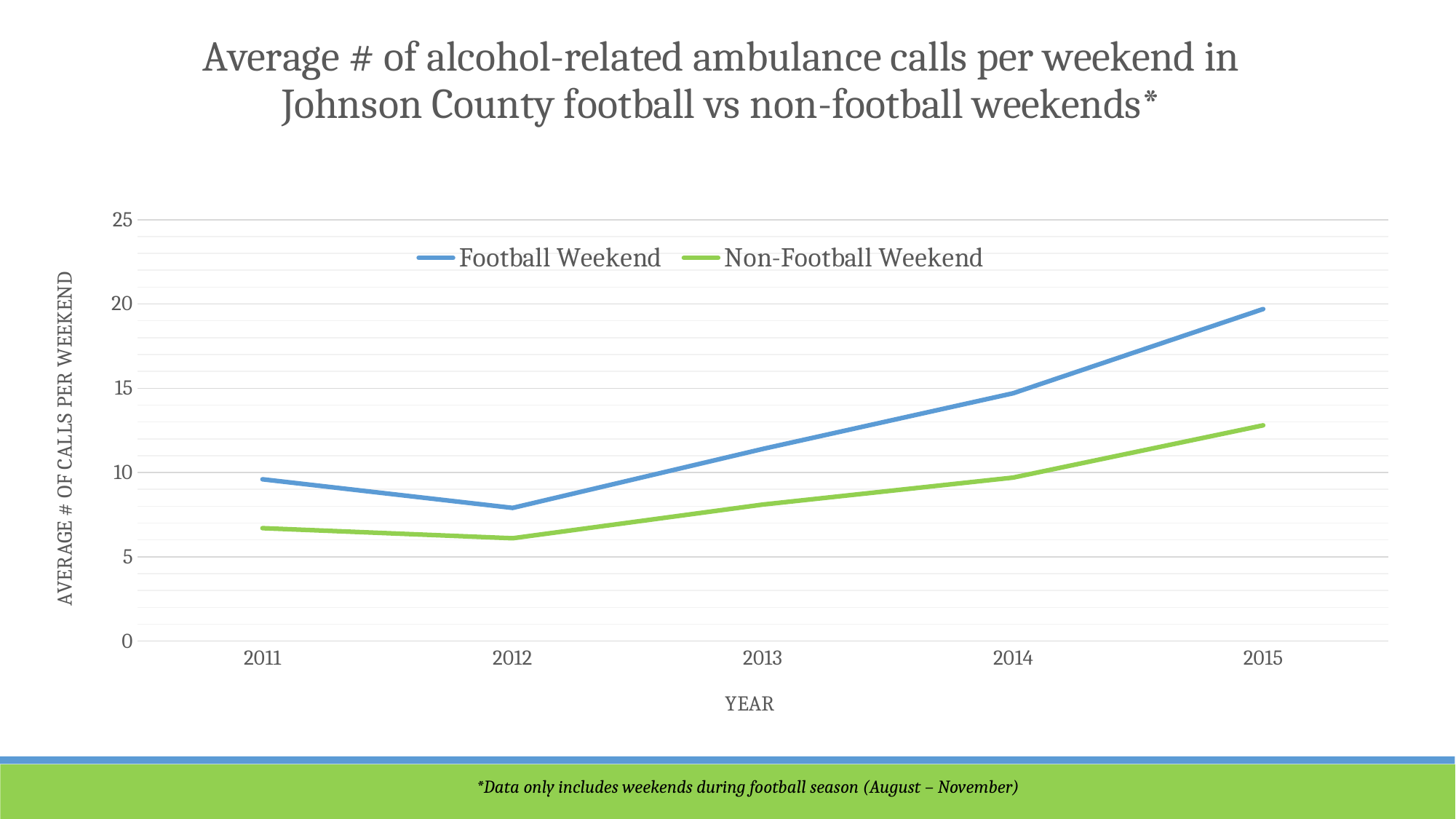
Is the Non-Football Weekend value for 2015 greater or less than 10? greater How many years are plotted along the x axis? 5 Is the Football Weekend value for 2012 greater or less than 10? less In which year is the Non-Football Weekend value lowest? 2012 How many series does the legend list? 2 In which year is the Football Weekend value lowest? 2012 Which series has the larger value in 2015, Football Weekend or Non-Football Weekend? Football Weekend Do the Football Weekend values rise or fall from 2012 to 2015? rise In which year is the Football Weekend value highest? 2015 Is the Football Weekend value for 2015 greater or less than 15? greater What colour is the Football Weekend line? blue What kind of chart is shown on the slide? line chart